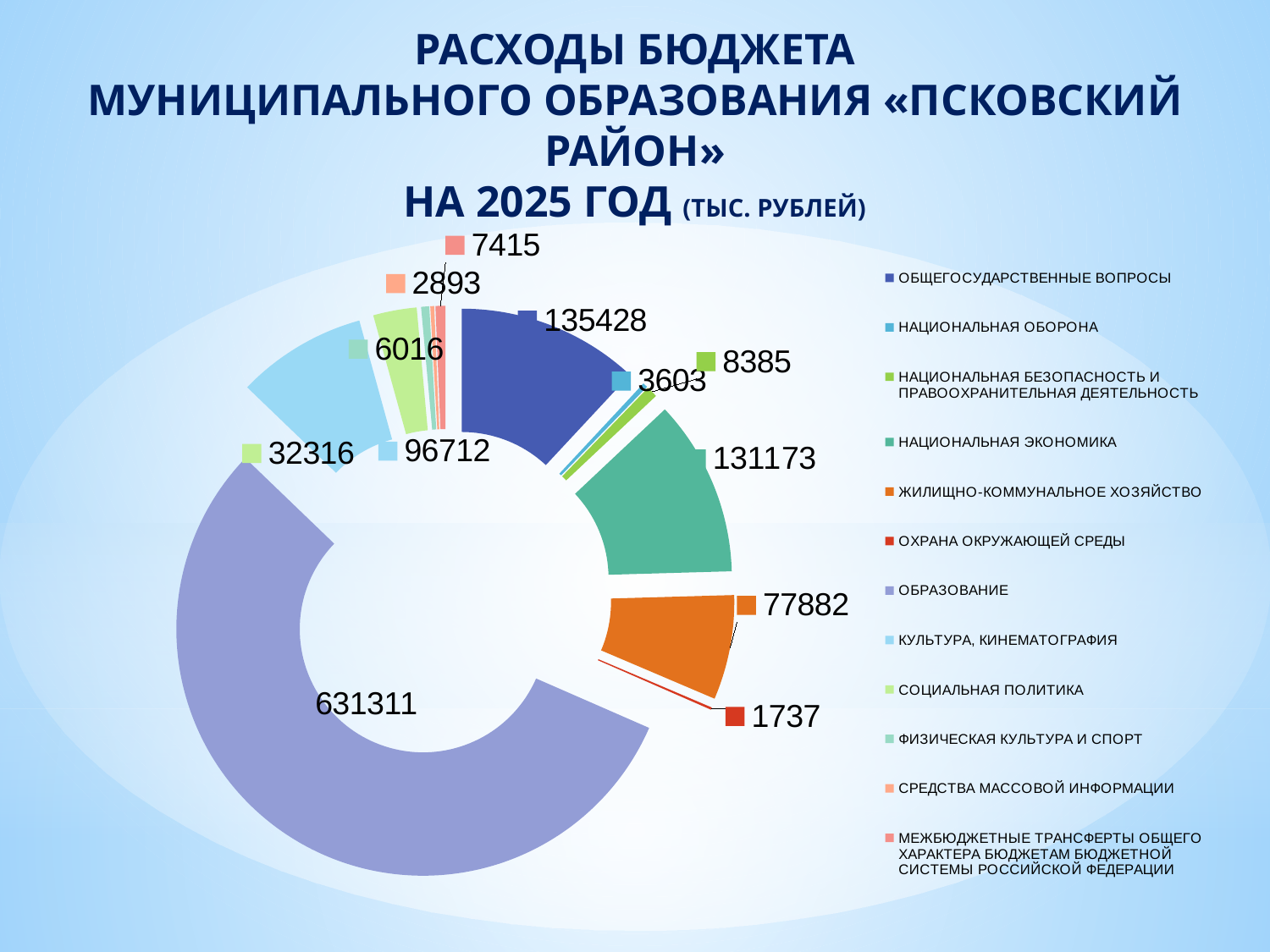
What is the difference between КУЛЬТУРА, КИНЕМАТОГРАФИЯ and ЖИЛИЩНО-КОММУНАЛЬНОЕ ХОЗЯЙСТВО? 18830 What is the value for КУЛЬТУРА, КИНЕМАТОГРАФИЯ? 96712 What is the value for ОБРАЗОВАНИЕ? 631311 What is the value for НАЦИОНАЛЬНАЯ ЭКОНОМИКА? 131173 What type of chart is shown on the slide? Doughnut (pie) chart How many categories does the legend list? 12 Which category has the largest value? ОБРАЗОВАНИЕ What is the difference between ОБЩЕГОСУДАРСТВЕННЫЕ ВОПРОСЫ and НАЦИОНАЛЬНАЯ ЭКОНОМИКА? 4255 Which is larger: НАЦИОНАЛЬНАЯ ОБОРОНА or НАЦИОНАЛЬНАЯ БЕЗОПАСНОСТЬ И ПРАВООХРАНИТЕЛЬНАЯ ДЕЯТЕЛЬНОСТЬ? НАЦИОНАЛЬНАЯ БЕЗОПАСНОСТЬ И ПРАВООХРАНИТЕЛЬНАЯ ДЕЯТЕЛЬНОСТЬ Which category has the smallest value? ОХРАНА ОКРУЖАЮЩЕЙ СРЕДЫ In what units are the values on the chart given, according to the title? тыс. рублей What is the value for ЖИЛИЩНО-КОММУНАЛЬНОЕ ХОЗЯЙСТВО? 77882